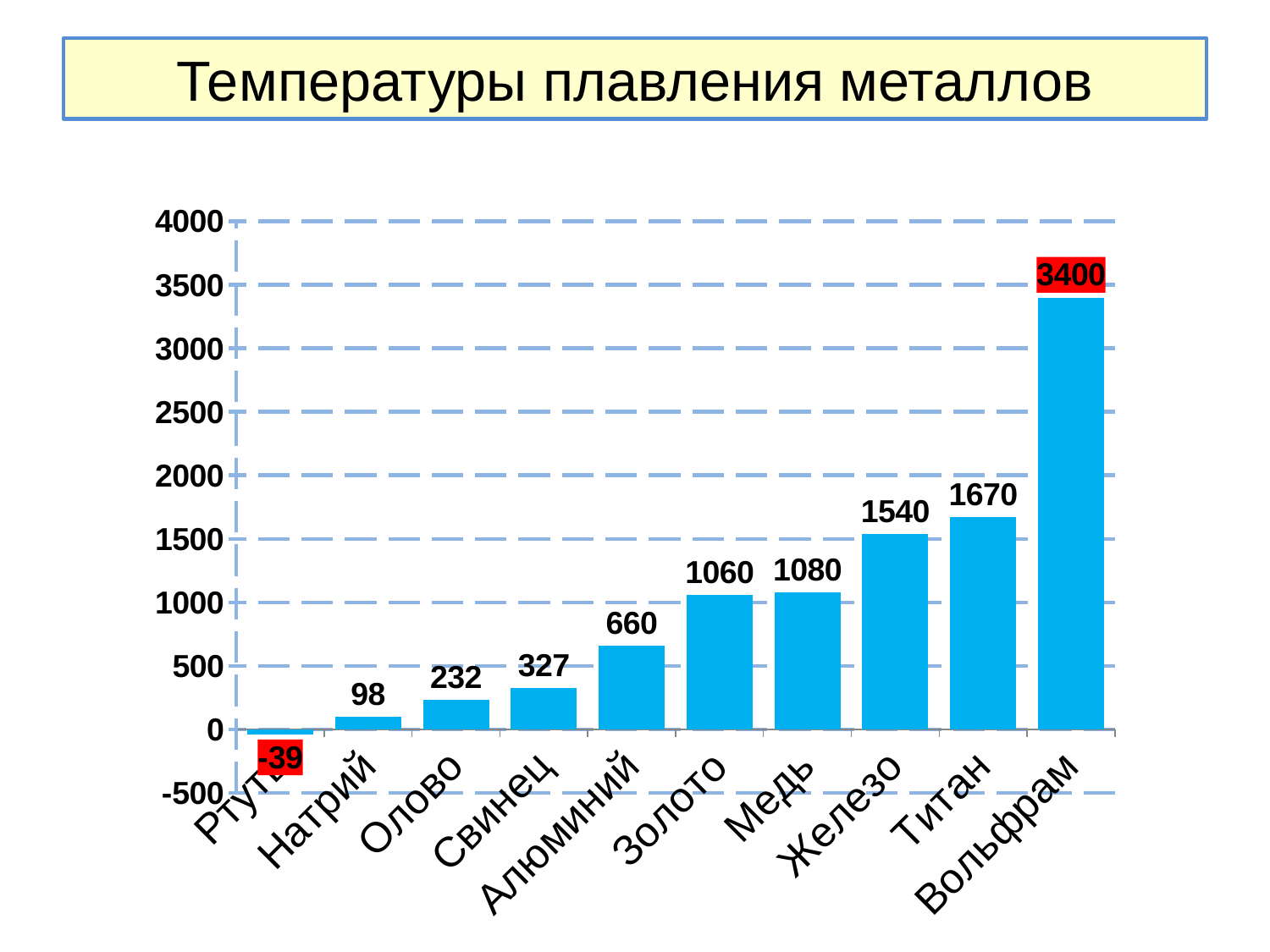
What is the difference between the values for Титан and Железо? 130 Which metal has the highest melting temperature on the chart? Вольфрам How many metals are shown on the chart? 10 What is the melting temperature shown for Вольфрам? 3400 Is the value for Железо greater or less than 1500? greater What is the title of the slide? Температуры плавления металлов Which metal has the lowest value on the chart? Ртуть Which has a higher value, Золото or Медь? Медь What kind of chart is shown on the slide? Bar chart What is the difference between the values for Вольфрам and Титан? 1730 What value is shown for Ртуть? -39 What value is shown for Алюминий? 660